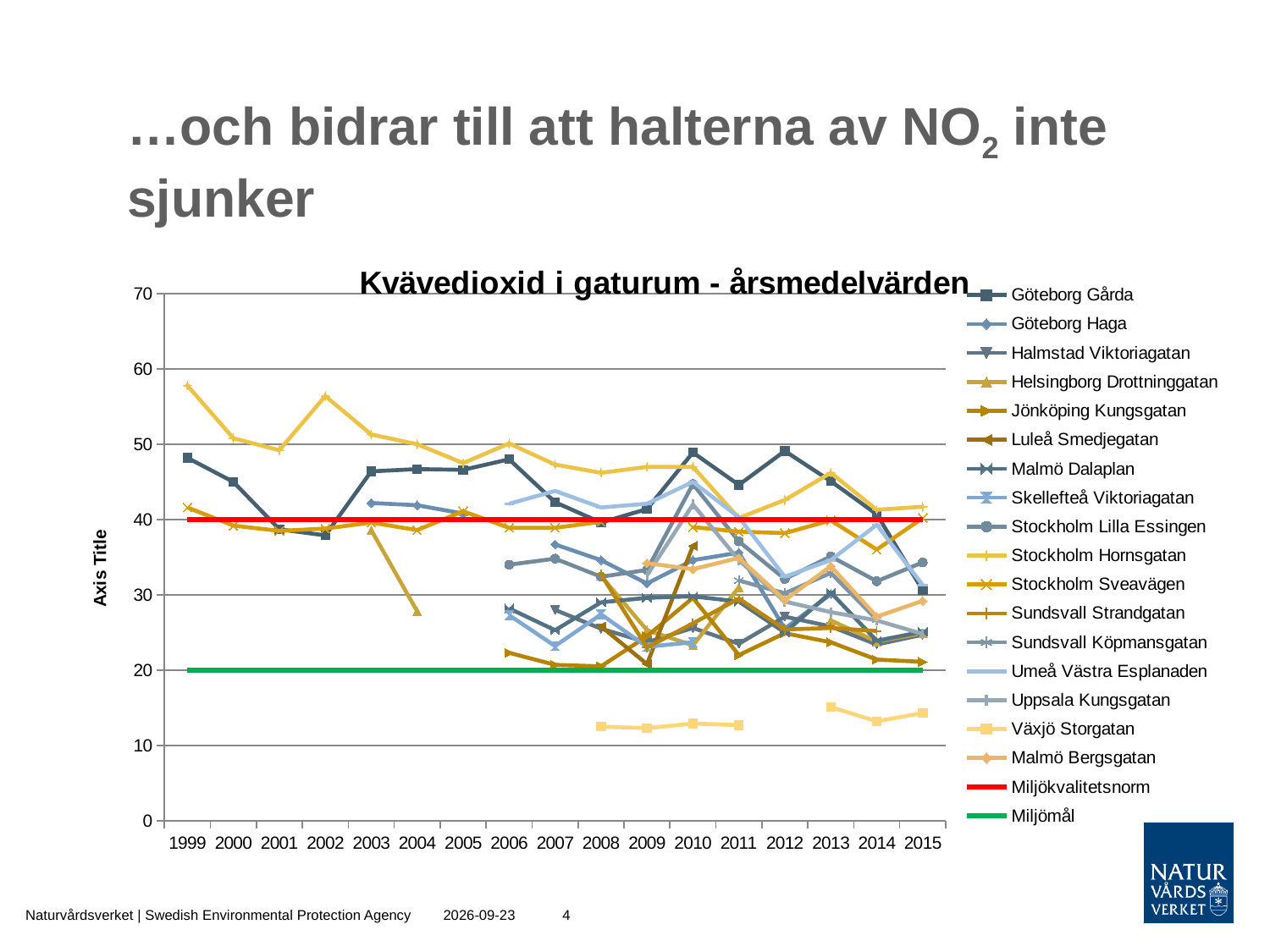
Is the value for Växjö Storgatan in 2010 greater or less than 20? less Does the Stockholm Hornsgatan line rise or fall from 1999 to 2015? fall Is the value for Stockholm Hornsgatan in 1999 greater or less than 50? greater What value does the Miljökvalitetsnorm line sit at? 40 What is the title of the chart? Kvävedioxid i gaturum - årsmedelvärden What type of chart is shown on the slide? line chart Is the value for Helsingborg Drottninggatan in 2004 greater or less than 30? less How many series does the legend list? 19 Which series has the lowest values in the chart? Växjö Storgatan What value does the Miljömål line sit at? 20 Which series has the highest value in 1999? Stockholm Hornsgatan How many years are shown on the x axis? 17